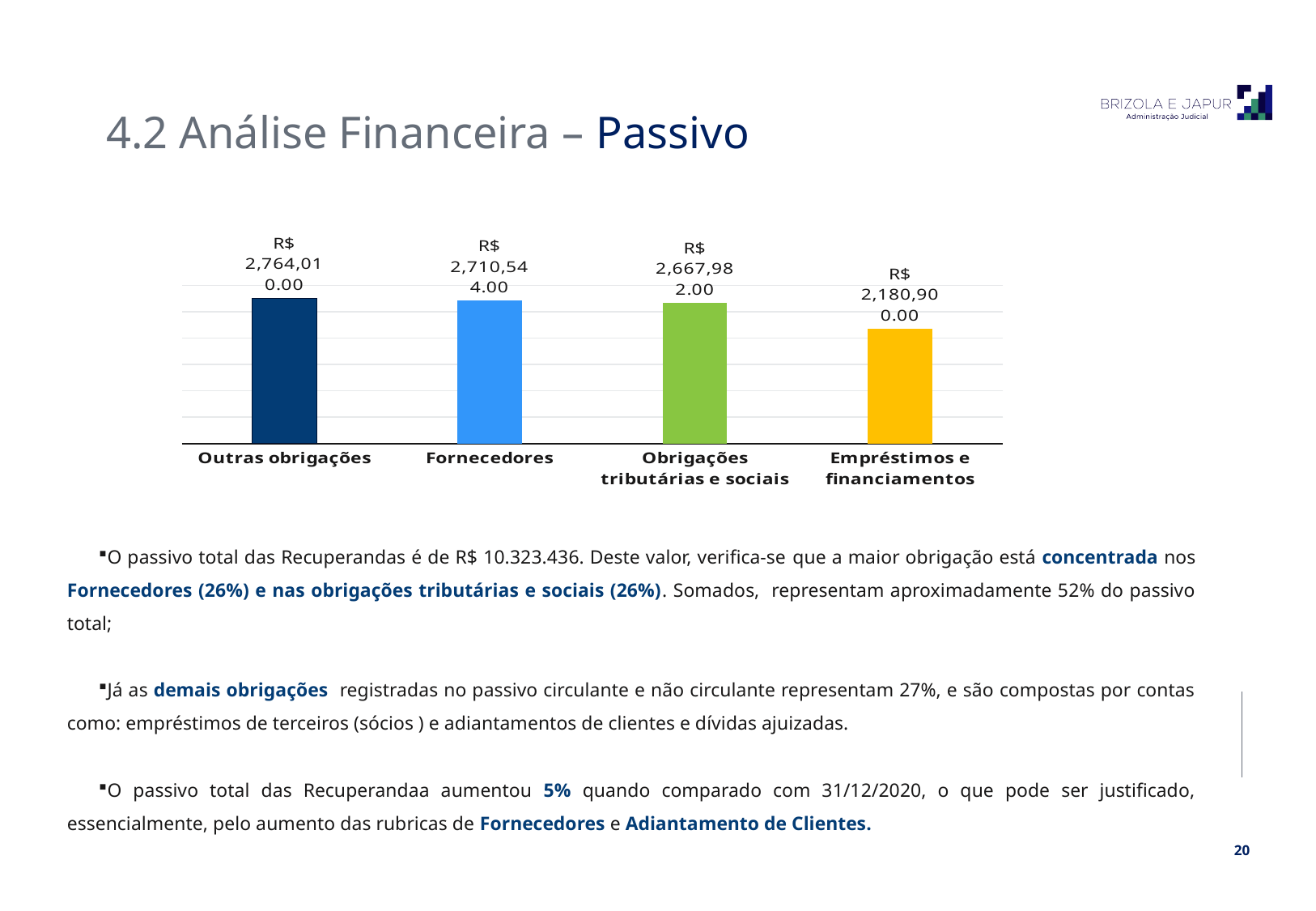
What is the difference between the values for Fornecedores and Obrigações tributárias e sociais? R$ 42,562.00 What is the value shown for Outras obrigações? R$ 2,764,010.00 Which category has the highest value in the chart? Outras obrigações Which category has the lowest value in the chart? Empréstimos e financiamentos Which is larger, the value for Fornecedores or the value for Obrigações tributárias e sociais? Fornecedores What is the difference between the values for Outras obrigações and Empréstimos e financiamentos? R$ 583,110.00 What kind of chart is shown on the slide? Bar chart Do the bar values rise or fall from left to right across the chart? Fall What is the value shown for Obrigações tributárias e sociais? R$ 2,667,982.00 How many categories are plotted in the chart? 4 What is the value shown for Empréstimos e financiamentos? R$ 2,180,900.00 What is the value shown for Fornecedores? R$ 2,710,544.00